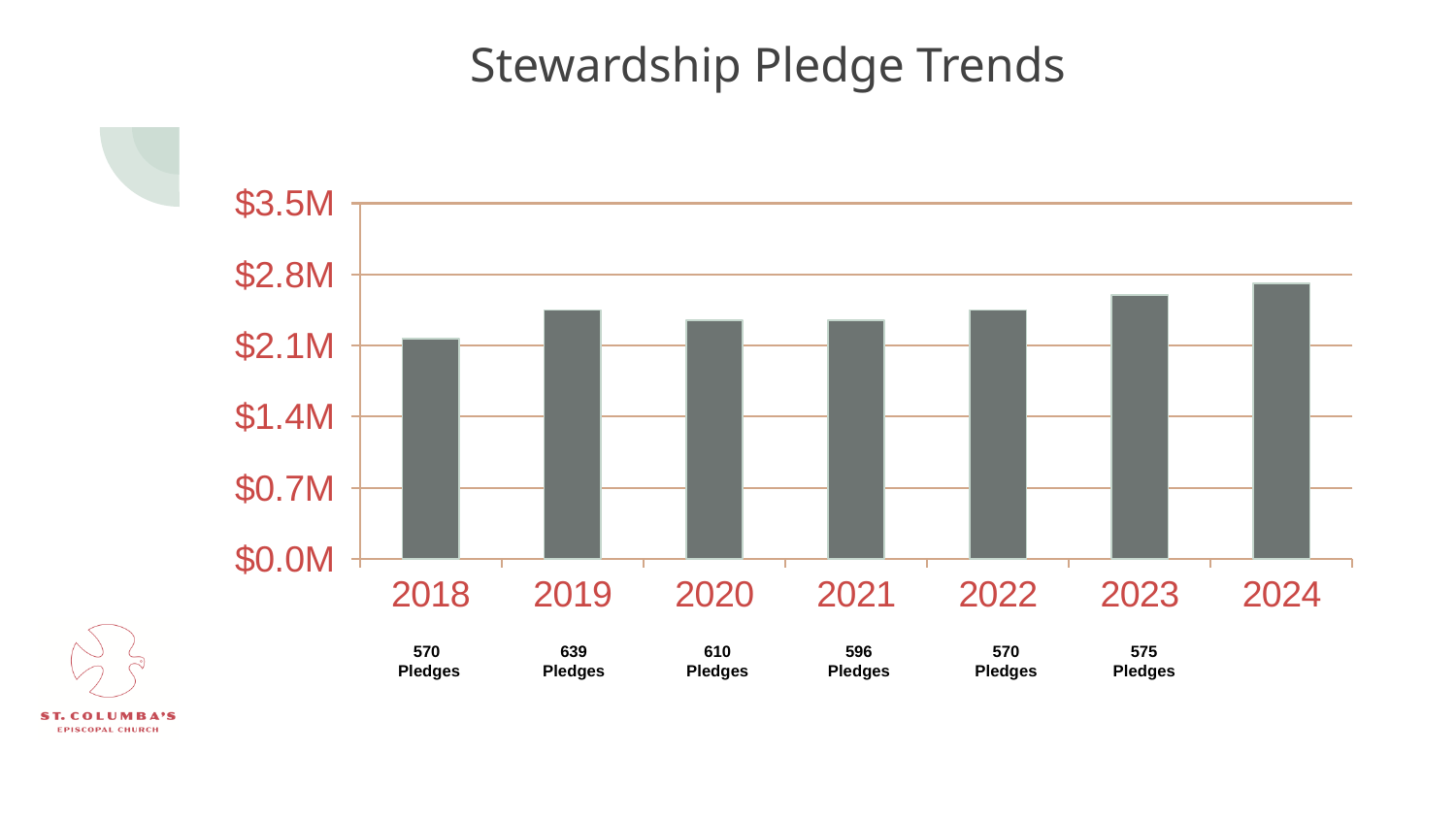
Which year has the lowest pledge total in the chart? 2018 Is the pledge total for 2023 greater or less than $2.1M? greater Overall, do the pledge totals rise or fall from 2018 to 2024? rise How many years are shown on the x axis of the chart? 7 Is the pledge total for 2024 greater or less than $2.8M? less What kind of chart is shown on the slide? bar chart How many pledges are listed under 2019? 639 Pledges Which year has the larger pledge total, 2020 or 2023? 2023 Which year has the highest pledge total in the chart? 2024 What is the title of the chart? Stewardship Pledge Trends Which year has the larger pledge total, 2018 or 2024? 2024 What is the difference between the number of pledges listed for 2019 and for 2018? 69